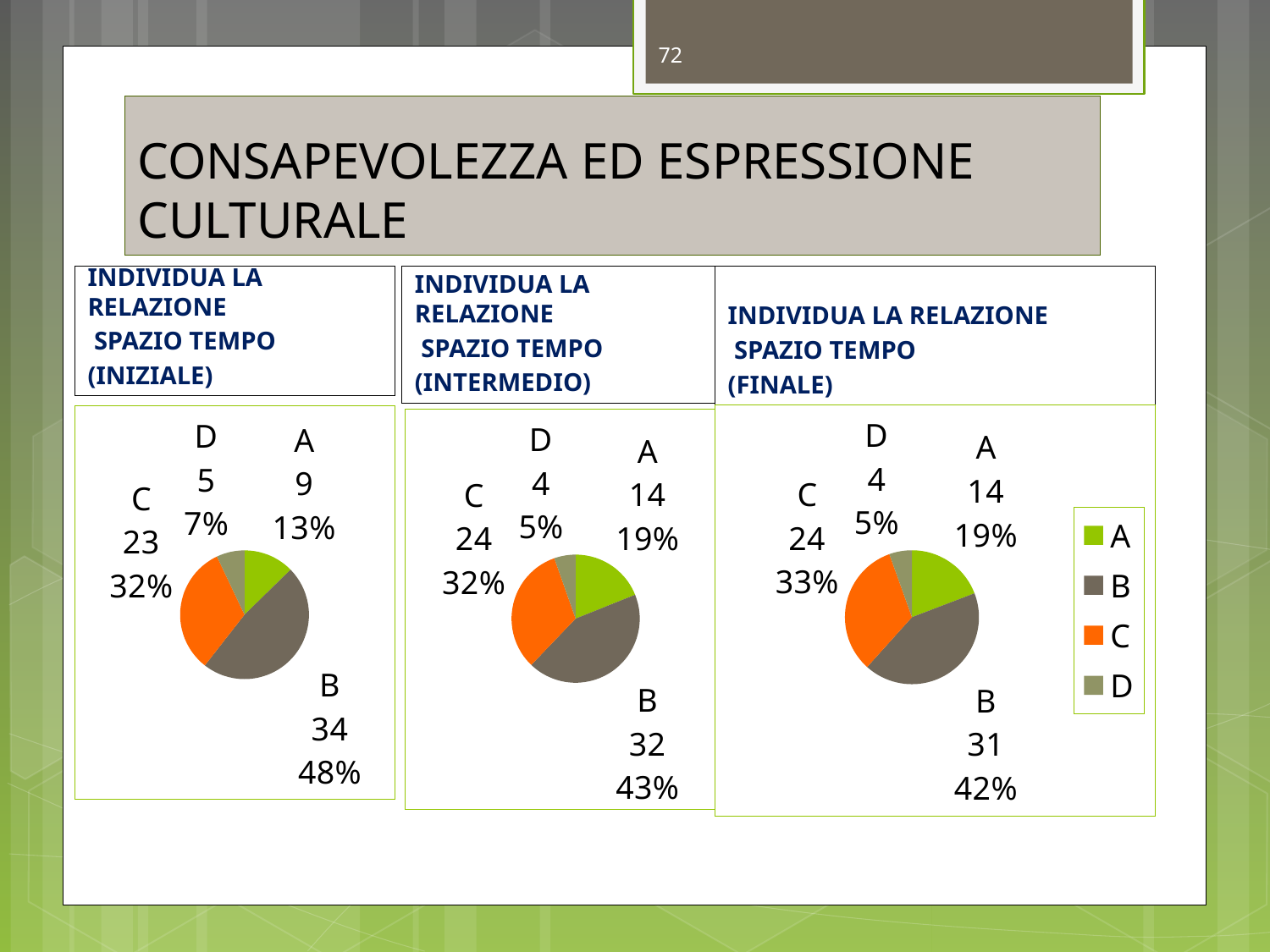
In the INIZIALE pie chart, what percentage share does category C have? 32% In the FINALE pie chart, what percentage share does category B have? 42% How many categories does the INTERMEDIO pie chart show? 4 In the FINALE pie chart, which is larger, the count for A or the count for C? C In the FINALE pie chart, which category has the smallest slice? D How many entries does the legend on the right of the slide list? 4 In the INTERMEDIO pie chart, what is the count for category A? 14 What type of chart is used for the INIZIALE data? Pie chart In the INTERMEDIO pie chart, what is the difference between the counts for B and C? 8 In the INIZIALE pie chart, which category has the largest slice? B In the legend, which colour represents category C? Orange In the INIZIALE pie chart, what is the count for category B? 34